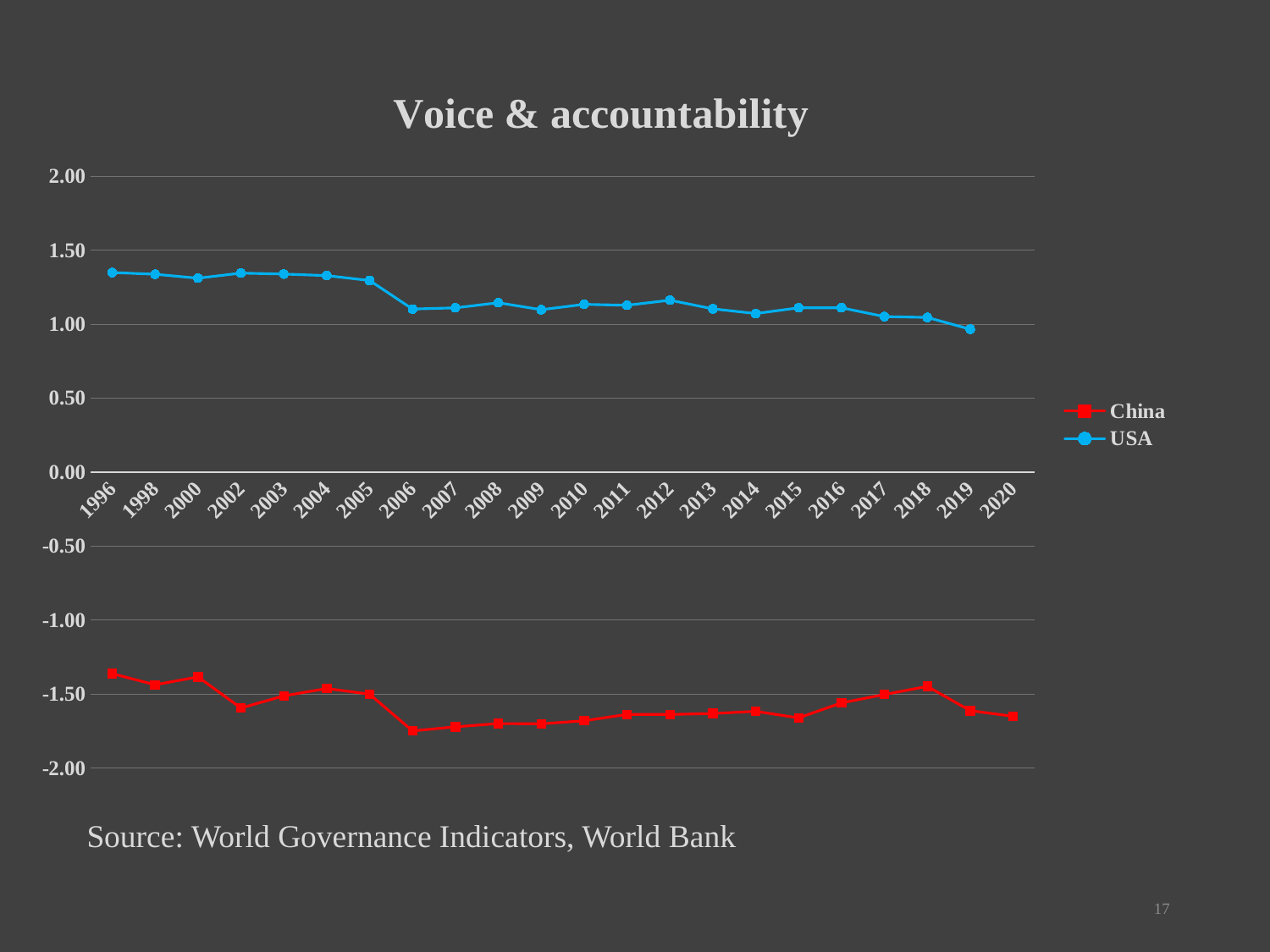
In which year does the China series reach its lowest value? 2006 Is the value for China in 1996 greater or less than -1.50? greater How many years are labelled on the x axis? 22 What is the title of the chart? Voice & accountability Which two series are shown in the legend? China and USA How many series does the legend list? 2 Which series has the higher value in 2010, China or USA? USA Is the value for China in 2006 greater or less than -1.50? less Is the value for USA in 2006 greater or less than 1.50? less In which year does the USA series reach its lowest value? 2019 What kind of chart is shown on the slide? line chart